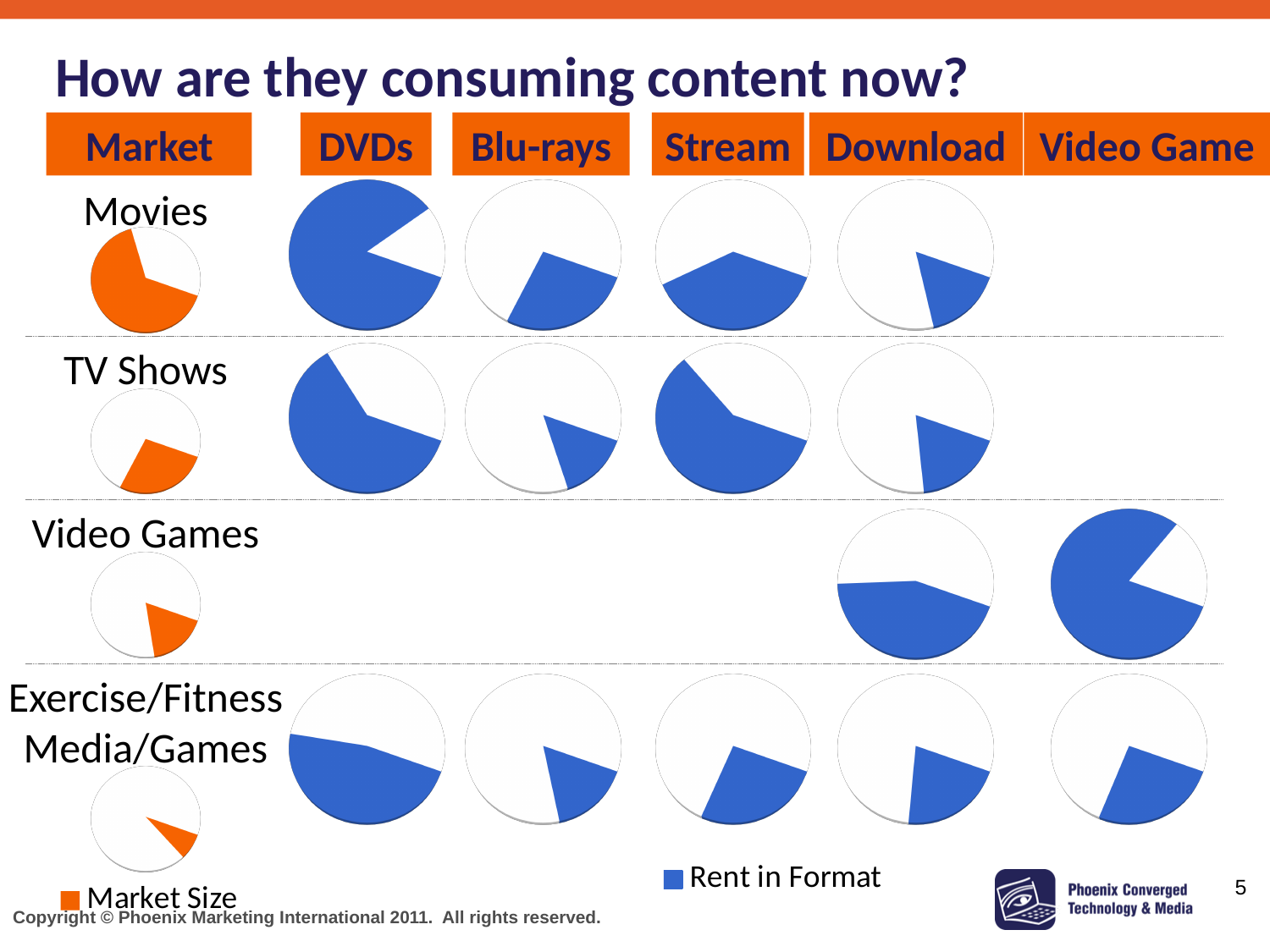
How many format columns (DVDs, Blu-rays, etc.) are shown in the header row? 5 In the Video Games row, which has the larger Rent in Format share: Download or Video Game? Video Game In the TV Shows row, which has the larger Rent in Format share: Stream or Download? Stream For Blu-rays, which market has the larger Rent in Format share: Movies or TV Shows? Movies How many blue Rent in Format pie charts are shown in the Video Games row? 2 What does the orange colour in the pie charts represent, according to the legend? Market Size What kind of chart is used throughout this slide to show market size and rent-in-format shares? Pie chart What does the blue colour in the pie charts represent, according to the legend? Rent in Format Among the orange Market Size pies, which market has the smallest share? Exercise/Fitness Media/Games Among the orange Market Size pies, which market has the largest share? Movies How many market rows (markets) are shown on the slide? 4